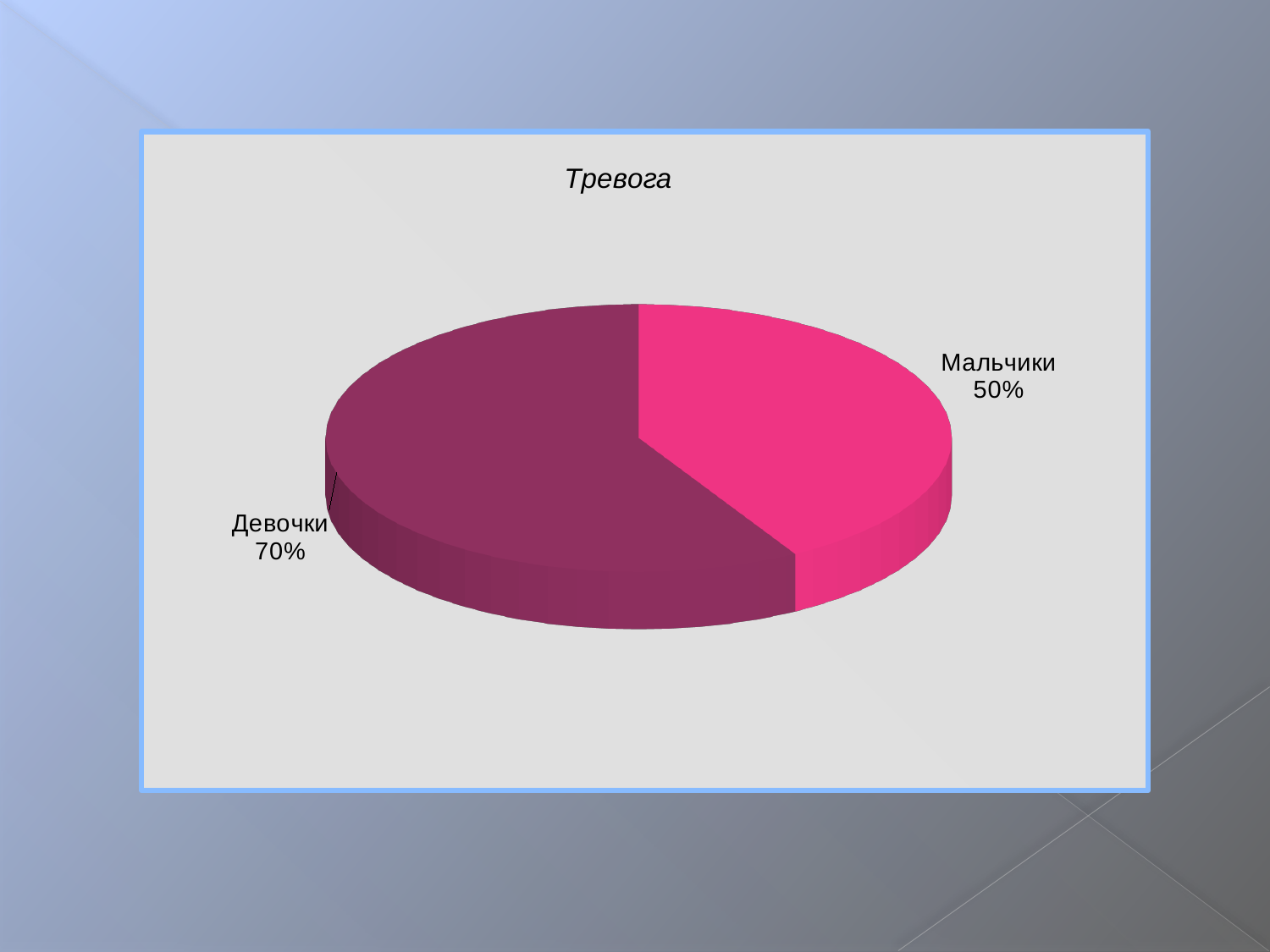
Which category has the larger slice of the pie? Девочки What percentage is shown for Девочки? 70% What colour is the slice for Мальчики? Pink What is the difference between the percentage for Девочки and the percentage for Мальчики? 20% What type of chart is shown on the slide? Pie chart What percentage is shown for Мальчики? 50% Which category has the smaller slice of the pie? Мальчики Which is larger, the value for Девочки or the value for Мальчики? Девочки What is the title of the chart? Тревога How many slices does the pie chart have? 2